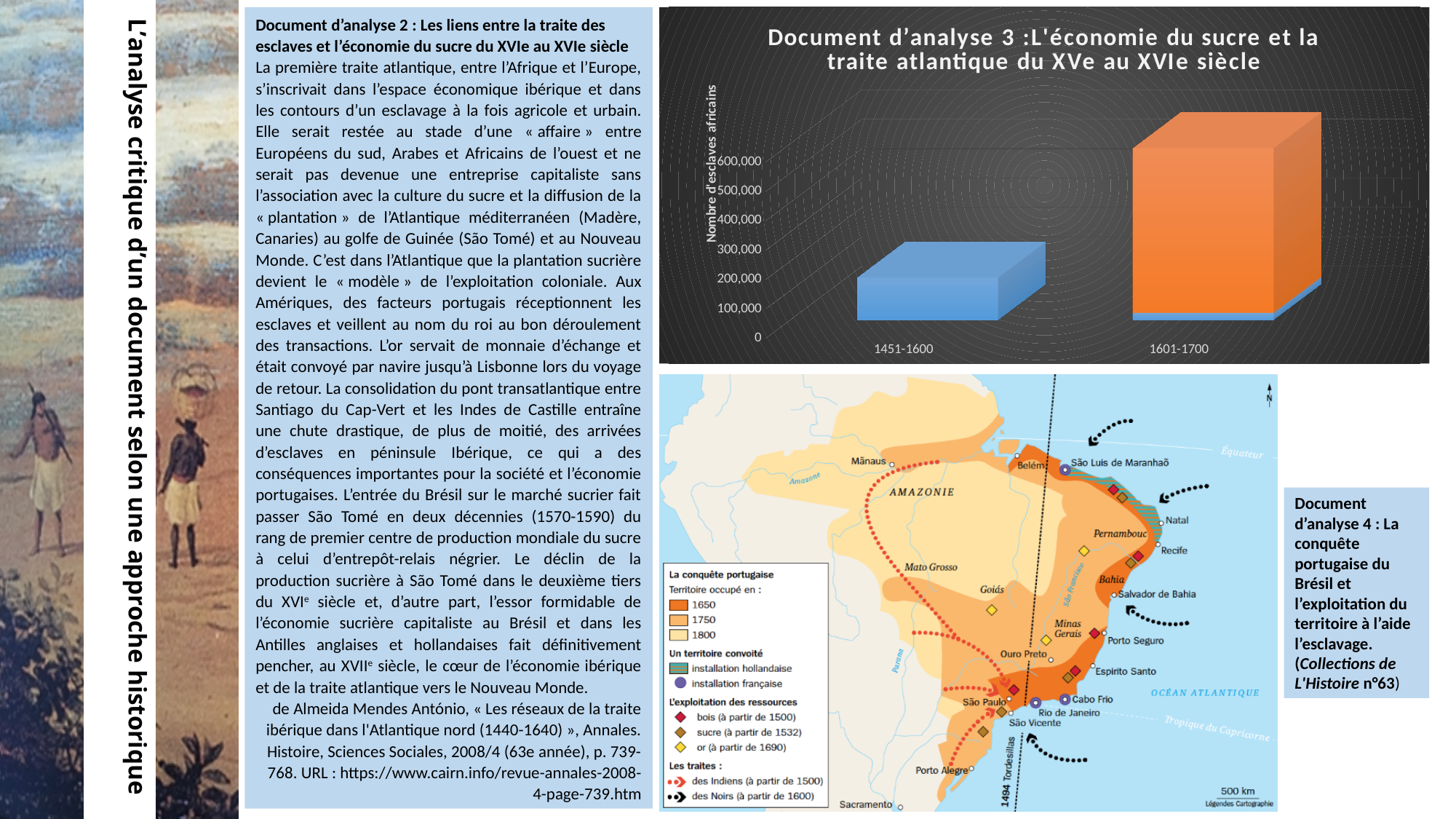
In the Document d'analyse 3 chart, is the value for 1601-1700 larger or smaller than the value for 1451-1600? larger In the Document d'analyse 3 chart, which period has the lowest number of African slaves? 1451-1600 What is the label of the vertical axis in the Document d'analyse 3 chart? Nombre d'esclaves africains In the Document d'analyse 3 chart, is the value for 1601-1700 greater or less than 300,000? greater How many periods (categories) are plotted in the Document d'analyse 3 chart? 2 In the Document d'analyse 3 chart, does the number of African slaves rise or fall from 1451-1600 to 1601-1700? rise In the Document d'analyse 3 chart, is the value for 1601-1700 greater or less than 400,000? greater What is the title of the chart in the top right of the slide? Document d'analyse 3 : L'économie du sucre et la traite atlantique du XVe au XVIe siècle In the Document d'analyse 3 chart, is the value for 1451-1600 greater or less than 400,000? less In the Document d'analyse 3 chart, which period has the highest number of African slaves? 1601-1700 What kind of chart is shown in Document d'analyse 3? bar chart